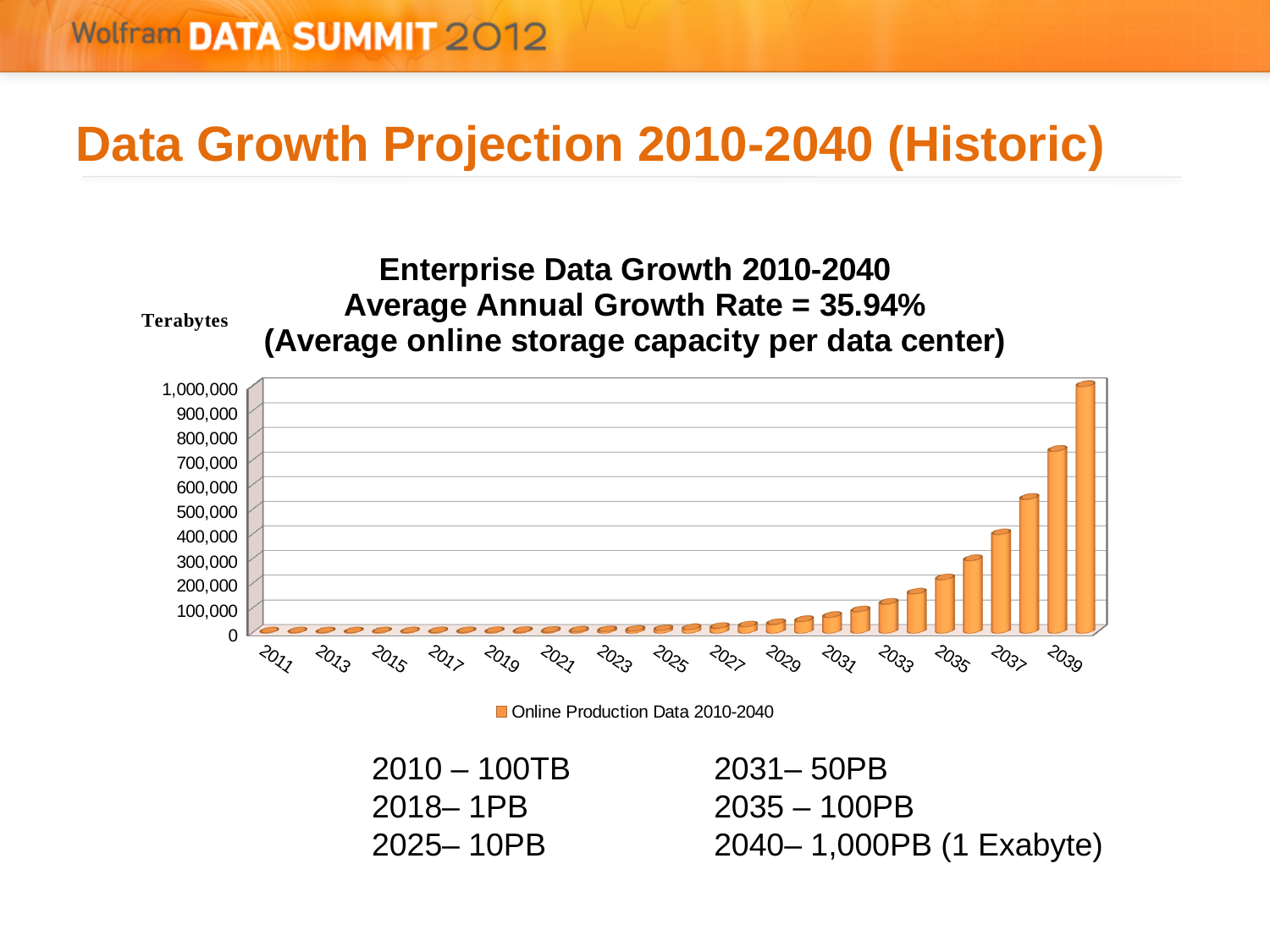
How many series does the chart legend list? 1 Is the value for 2039 greater or less than 500,000? greater What average annual growth rate is stated in the chart title? 35.94% Which year has the larger value, 2031 or 2039? 2039 What type of chart is shown on the slide? bar chart Is the value for 2021 greater or less than 100,000? less What is the name of the series in the chart legend? Online Production Data 2010-2040 Do the values rise or fall from left to right along the x axis? rise According to the annotations below the chart, what is the value for 2010? 100TB According to the annotations below the chart, what is the value for 2040? 1,000PB According to the annotations below the chart, what is the value for 2035? 100PB What is the title of the chart? Enterprise Data Growth 2010-2040 Average Annual Growth Rate = 35.94% (Average online storage capacity per data center)